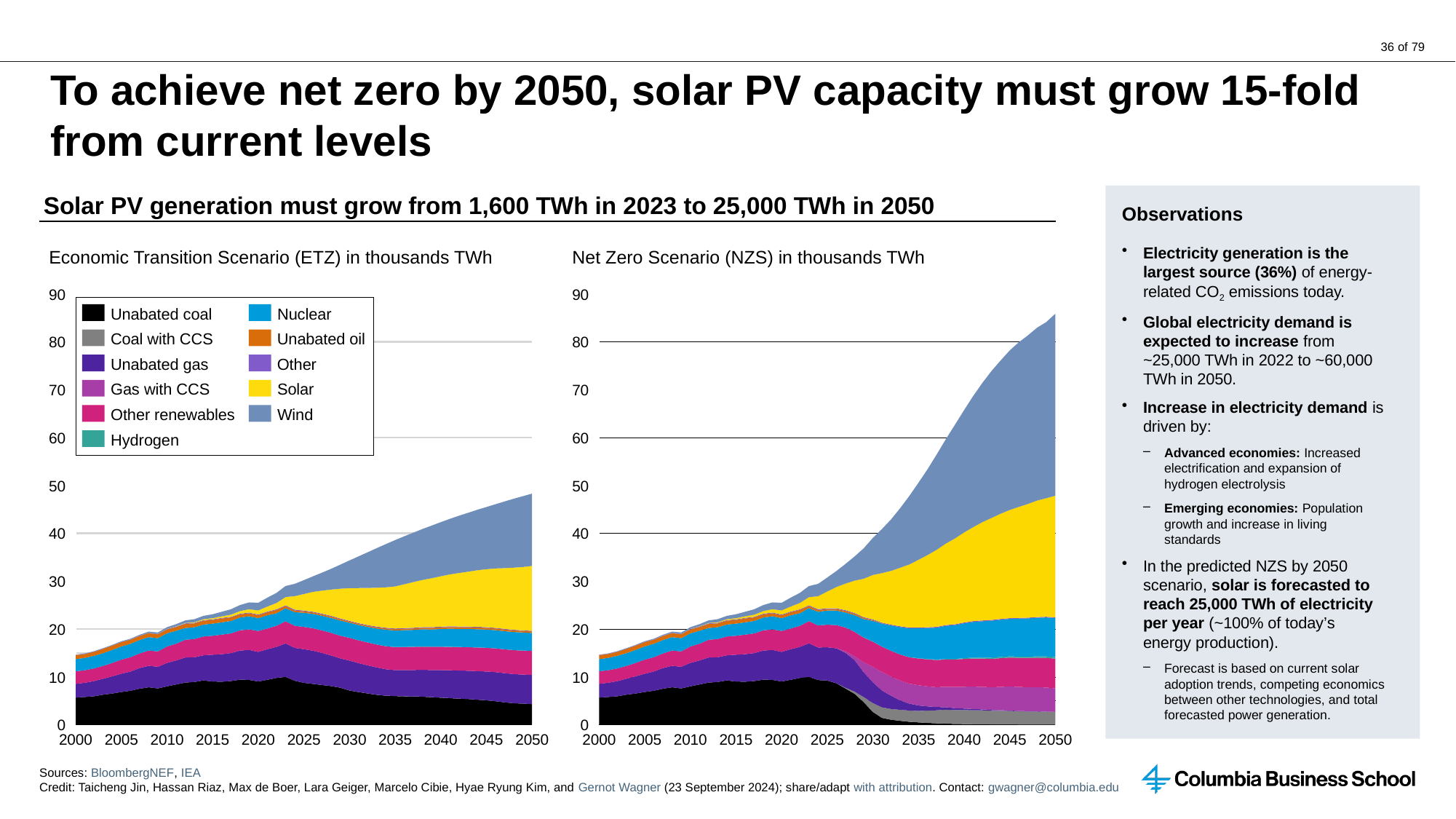
In the Net Zero Scenario (NZS) chart, does total generation rise or fall from 2000 to 2050? Rise How many year labels are shown on the x axis of the Net Zero Scenario (NZS) chart? 11 In the Economic Transition Scenario (ETZ) chart, is the total generation in 2050 greater or less than 50? less In the Net Zero Scenario (NZS) chart, is the total generation in 2050 greater or less than 80? greater What colour represents Solar in the legend of the Economic Transition Scenario (ETZ) chart? Yellow In the Net Zero Scenario (NZS) chart, does the Unabated coal area grow or shrink between 2025 and 2035? Shrink What is the highest value shown on the y axis of the Economic Transition Scenario (ETZ) chart? 90 What kind of chart is the Economic Transition Scenario (ETZ) chart? Stacked area chart In the Net Zero Scenario (NZS) chart, is the total generation in 2040 greater or less than 60? greater How many series does the legend on the Economic Transition Scenario (ETZ) chart list? 11 Which chart shows the larger total generation in 2050, the Economic Transition Scenario (ETZ) chart or the Net Zero Scenario (NZS) chart? Net Zero Scenario (NZS)